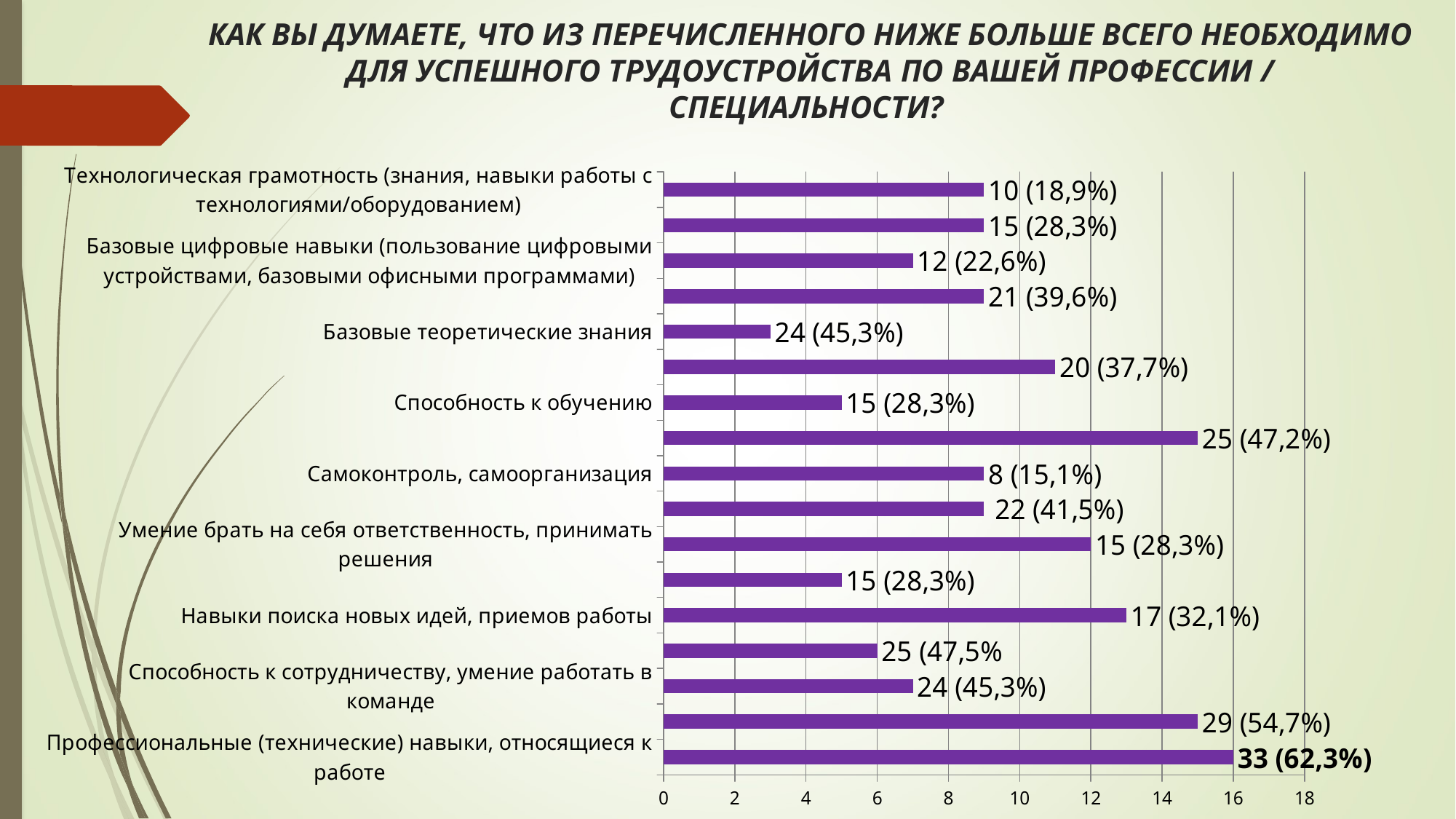
What is the data label for "Самоконтроль, самоорганизация"? 8 (15,1%) What is the difference between the counts labelled for "Профессиональные (технические) навыки, относящиеся к работе" (33) and "Технологическая грамотность" (10)? 23 Is the bar for "Профессиональные (технические) навыки, относящиеся к работе" greater or less than 14 on the axis? greater How many bars are plotted in the chart? 17 What is the data label for "Способность к сотрудничеству, умение работать в команде"? 24 (45,3%) Which is larger: the value for "Профессиональные (технические) навыки, относящиеся к работе" or for "Технологическая грамотность"? Профессиональные (технические) навыки, относящиеся к работе What is the data label for "Профессиональные (технические) навыки, относящиеся к работе"? 33 (62,3%) Which category has the longest bar? Профессиональные (технические) навыки, относящиеся к работе What is the data label for "Навыки поиска новых идей, приемов работы"? 17 (32,1%) What kind of chart is shown on the slide? bar chart What is the highest value shown on the horizontal axis? 18 What is the data label for "Технологическая грамотность (знания, навыки работы с технологиями/оборудованием)"? 10 (18,9%)